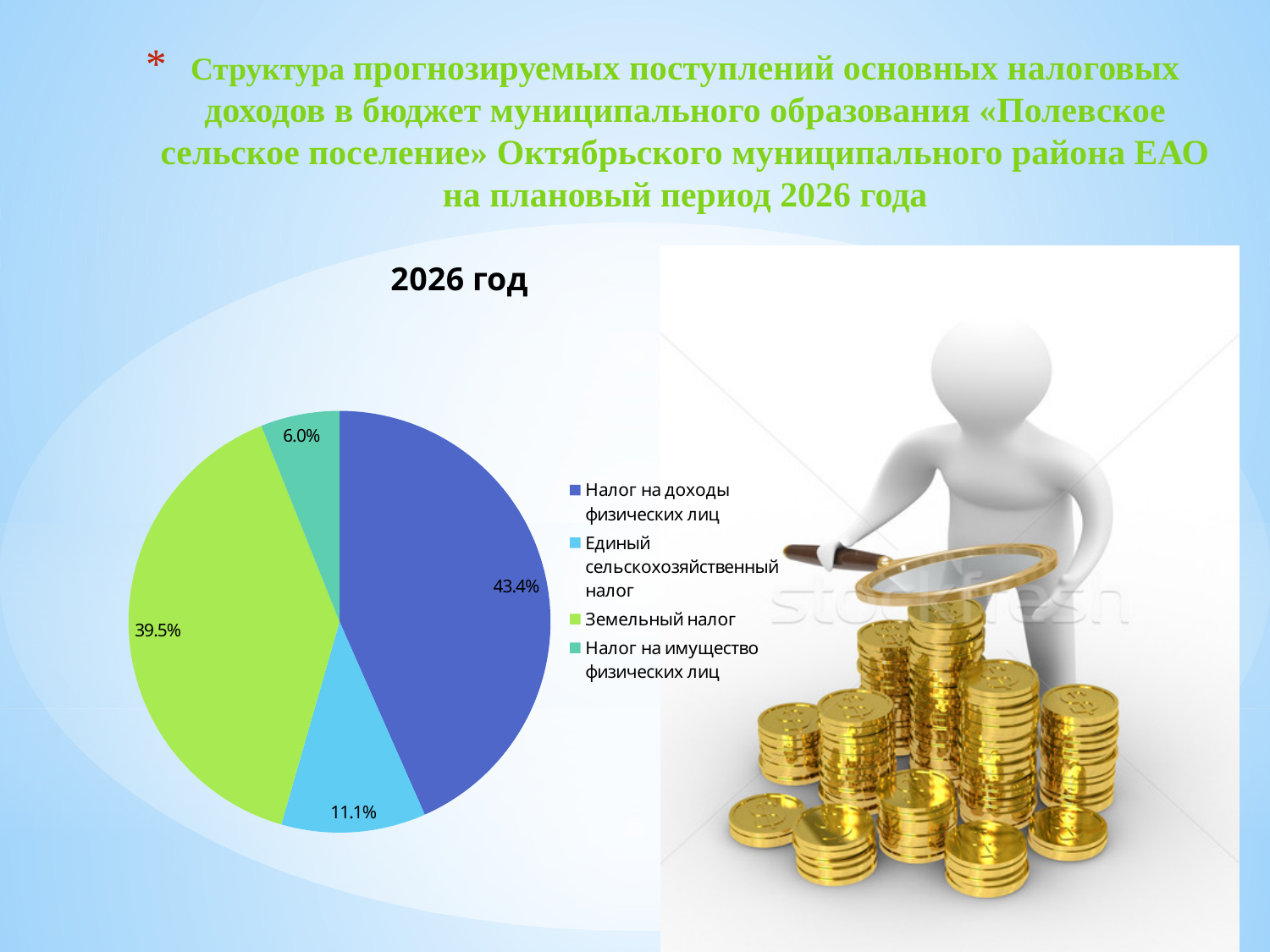
What share of the pie does Земельный налог have? 39.5% Which category has the largest slice of the pie? Налог на доходы физических лиц What is the difference in percentage points between Налог на доходы физических лиц and Земельный налог? 3.9 What share of the pie does Налог на доходы физических лиц have? 43.4% What colour is the slice for Земельный налог? green Which category has the smallest slice of the pie? Налог на имущество физических лиц Which is larger: Единый сельскохозяйственный налог or Налог на имущество физических лиц? Единый сельскохозяйственный налог What share of the pie does Налог на имущество физических лиц have? 6.0% What kind of chart is shown on the slide? pie chart What share of the pie does Единый сельскохозяйственный налог have? 11.1% What is the chart's title? 2026 год How many categories does the pie chart show? 4